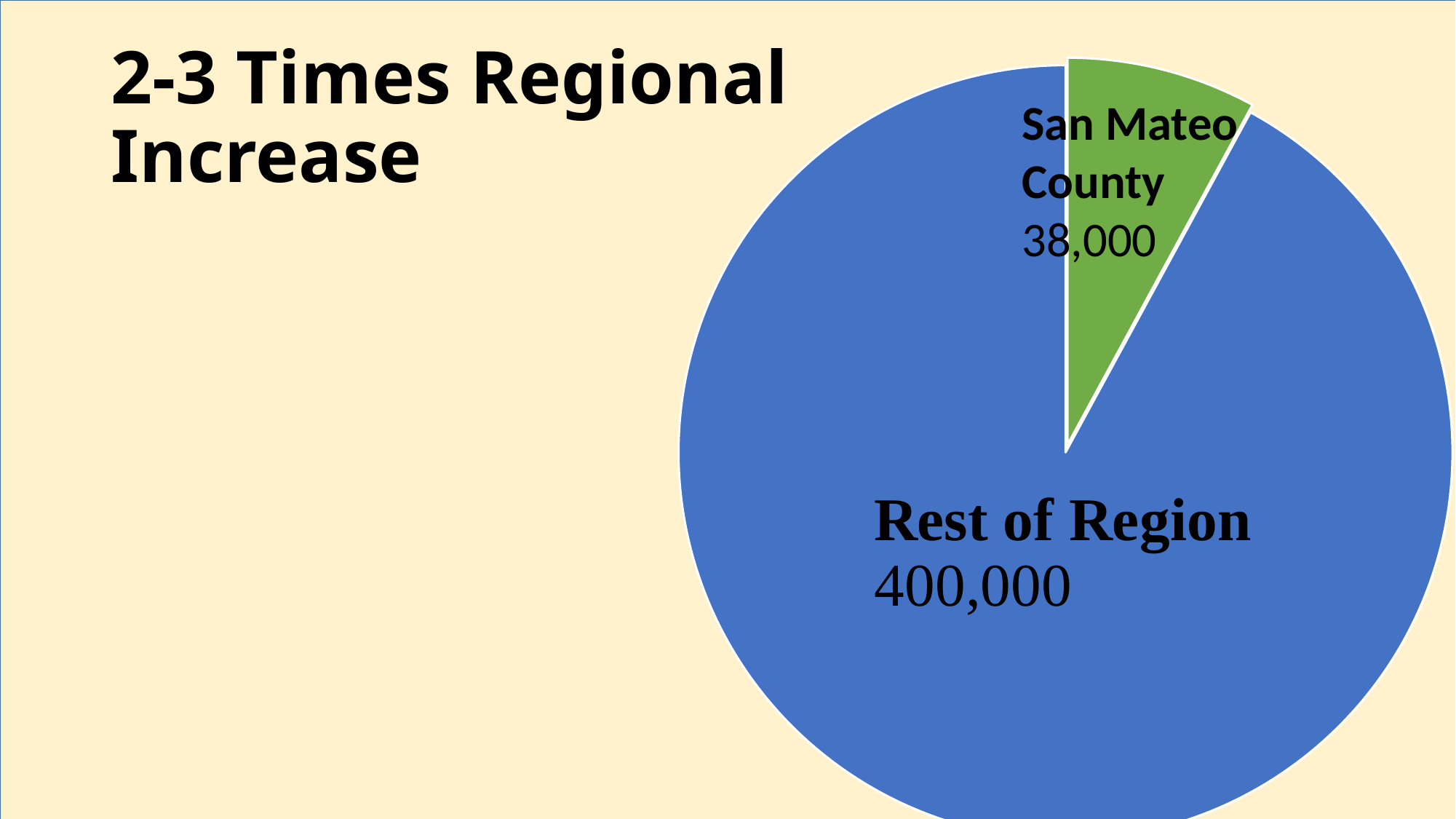
Which slice of the pie chart is the smallest? San Mateo County What colour is the San Mateo County slice? Green Which is larger, the value for San Mateo County or the value for Rest of Region? Rest of Region What is the difference between the Rest of Region value and the San Mateo County value? 362,000 How many slices does the pie chart have? 2 What colour is the Rest of Region slice? Blue What value is shown for San Mateo County in the pie chart? 38,000 Which slice of the pie chart is the largest? Rest of Region What kind of chart is shown on the slide? Pie chart What value is shown for Rest of Region in the pie chart? 400,000 What is the combined total of the two slices in the pie chart? 438,000